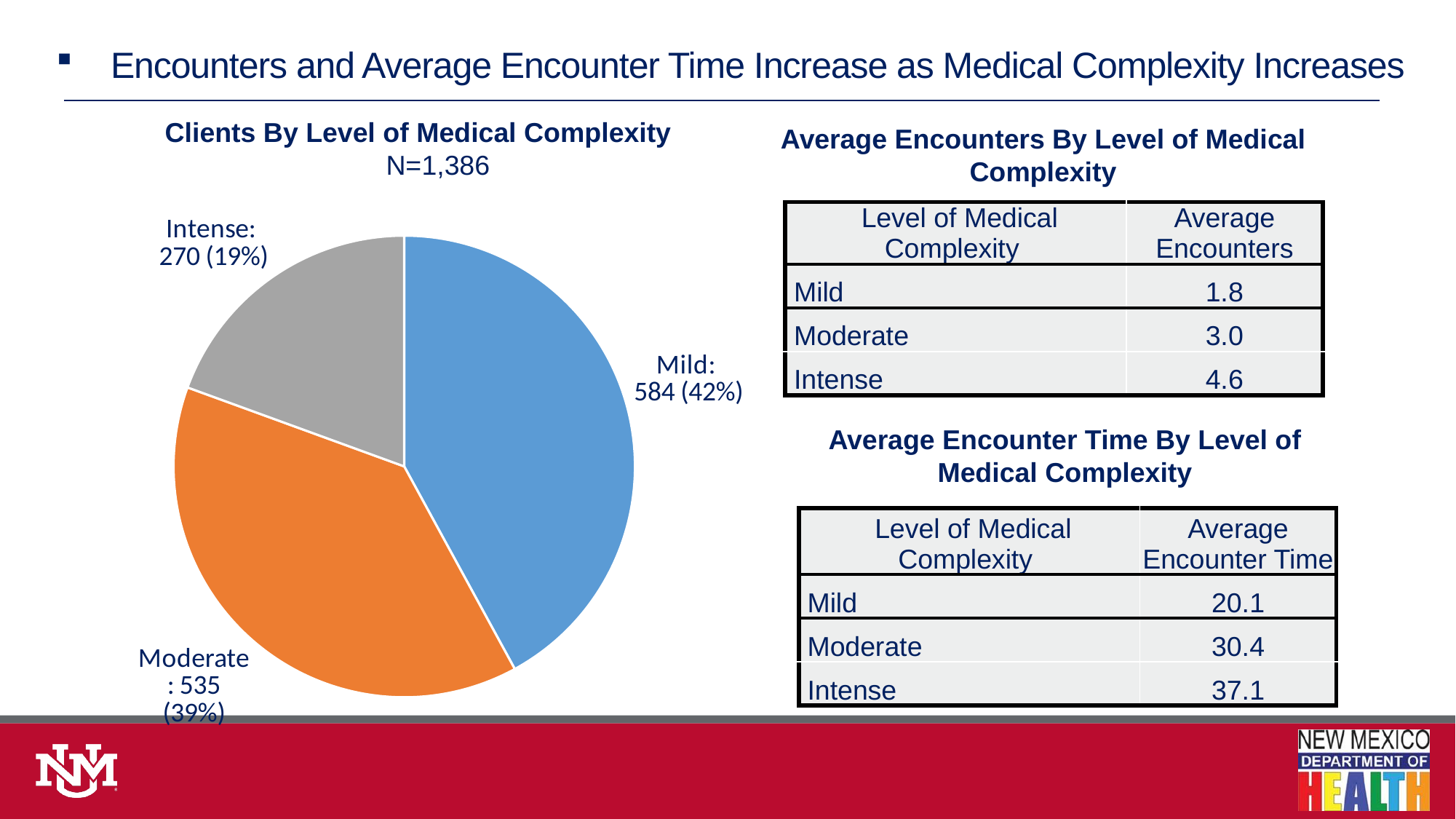
In the 'Clients By Level of Medical Complexity' pie chart, what is the difference in client count between Mild and Moderate? 49 In the 'Clients By Level of Medical Complexity' pie chart, which category has the smallest slice? Intense In the 'Clients By Level of Medical Complexity' pie chart, how many clients are in the Mild category? 584 In the 'Clients By Level of Medical Complexity' pie chart, how many clients are in the Moderate category? 535 In the 'Clients By Level of Medical Complexity' pie chart, what share of clients is Intense? 19% In the 'Clients By Level of Medical Complexity' pie chart, what is the total number of clients (N)? 1,386 In the 'Clients By Level of Medical Complexity' pie chart, what colour is the Moderate slice? orange What kind of chart is 'Clients By Level of Medical Complexity'? pie chart In the 'Clients By Level of Medical Complexity' pie chart, how many categories are shown? 3 In the 'Clients By Level of Medical Complexity' pie chart, what share of clients is Mild? 42% In the 'Clients By Level of Medical Complexity' pie chart, which category has the largest slice? Mild In the 'Clients By Level of Medical Complexity' pie chart, how many clients are in the Intense category? 270